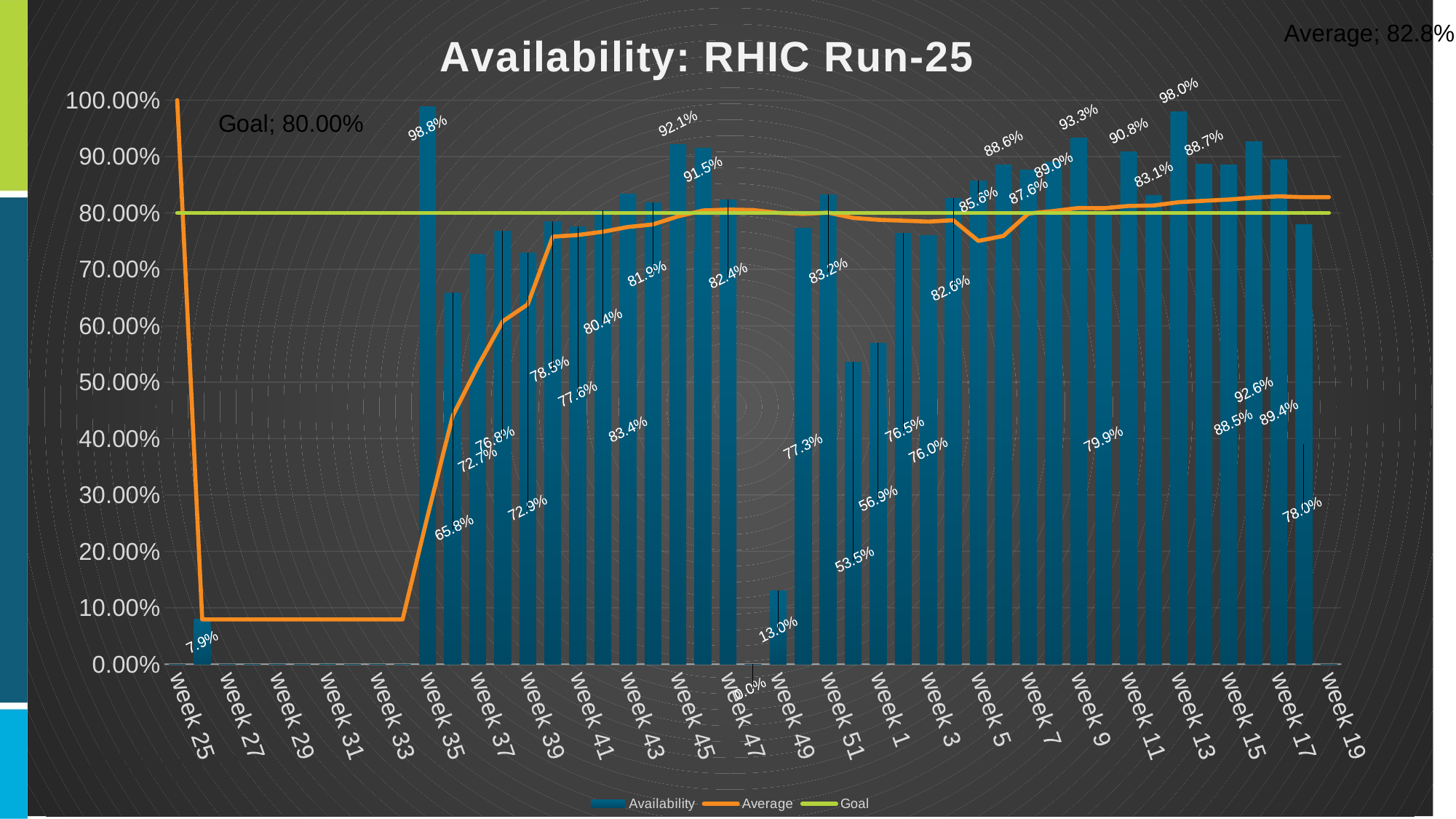
What kind of chart is used to show the weekly availability values? bar chart What are the three series named in the legend? Availability, Average, Goal What is the lowest availability value labelled on the chart? 0.0% What is the highest availability value labelled on the chart? 98.8% What is the availability for week 25? 0.0% What is the difference between the availability for week 35 (98.8%) and week 13 (98.0%)? 0.8% What is the availability for week 35? 98.8% What value is shown for the Average? 82.8% Which is larger, the availability for week 35 or for week 13? week 35 What is the title of the chart? Availability: RHIC Run-25 What value is shown for the Goal line? 80.00% How many series does the legend list? 3